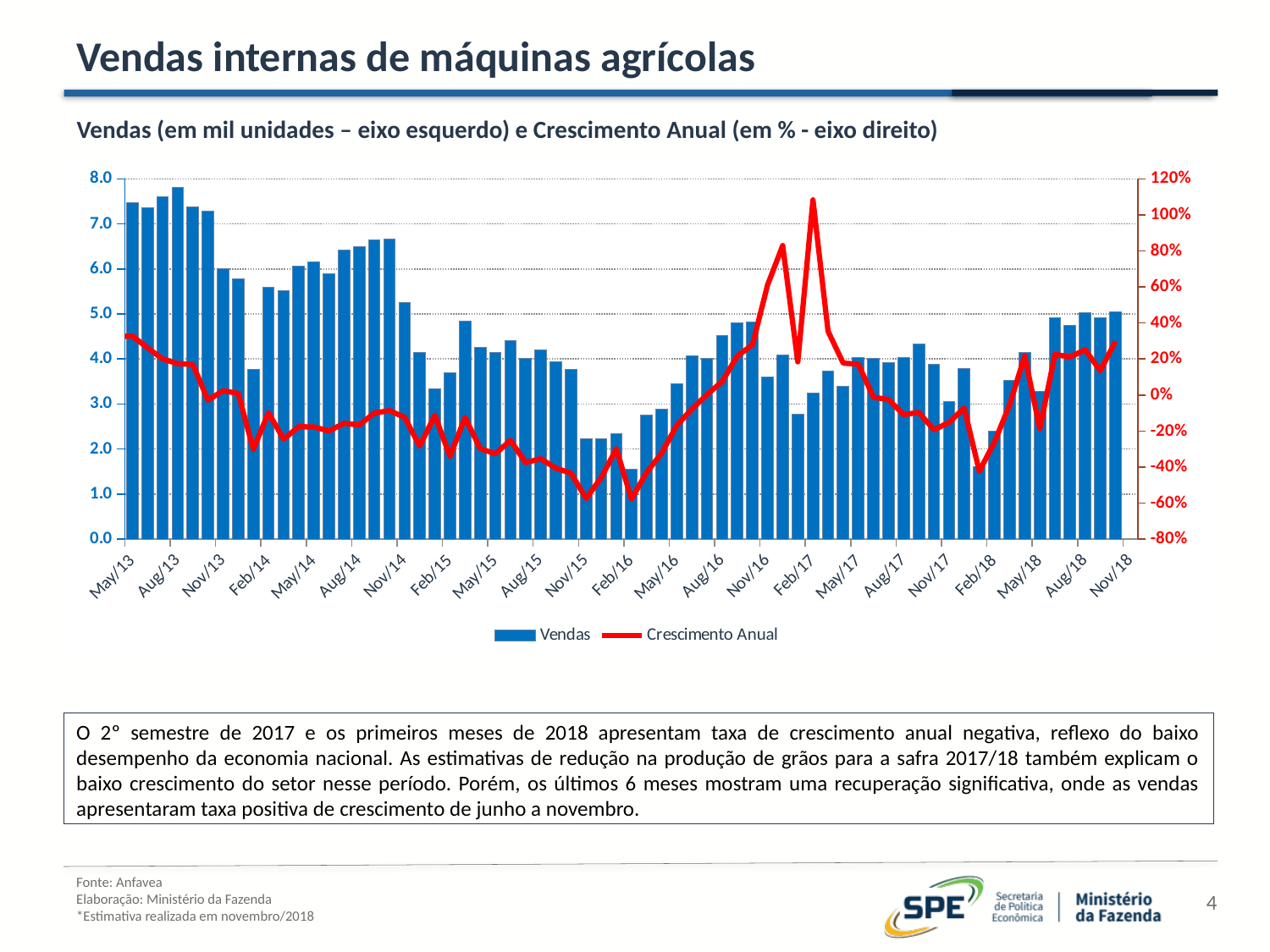
Which series is plotted as a red line? Crescimento Anual What are the two series named in the legend? Vendas and Crescimento Anual How many series does the legend list? 2 In which month does the Crescimento Anual line reach its peak? Feb/17 In which month do the Vendas bars reach their lowest value? Feb/16 What kind of chart is shown on the slide? Combined bar and line chart Is the Crescimento Anual value for Feb/18 greater or less than -20%? less Is the Vendas value for May/13 greater or less than 7.0? greater In which month do the Vendas bars reach their highest value? Aug/13 Is the Vendas value for Feb/16 greater or less than 2.0? less Which is larger, the Vendas value for May/13 or for Nov/18? May/13